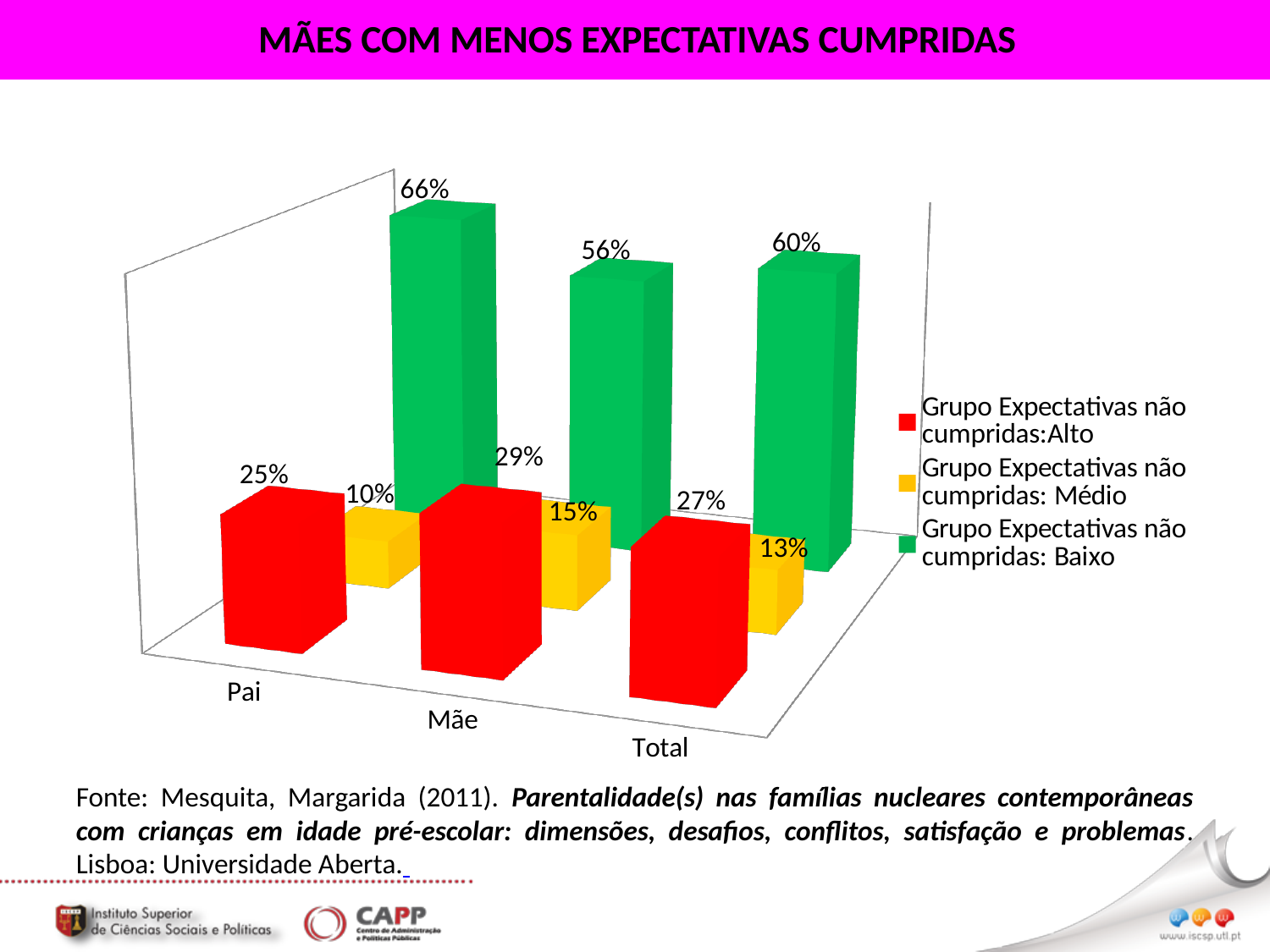
What is the value for Mãe in the series 'Grupo Expectativas não cumpridas: Baixo'? 56% How many series does the legend list? 3 How many categories are shown on the x axis? 3 What is the value for Pai in the series 'Grupo Expectativas não cumpridas: Baixo'? 66% What is the value for Mãe in the series 'Grupo Expectativas não cumpridas:Alto'? 29% What is the value for Total in the series 'Grupo Expectativas não cumpridas: Médio'? 13% Which category has the highest value in the series 'Grupo Expectativas não cumpridas: Baixo'? Pai What kind of chart is shown on the slide? bar chart Which category has the lowest value in the series 'Grupo Expectativas não cumpridas: Médio'? Pai What colour are the bars for the series 'Grupo Expectativas não cumpridas: Médio'? yellow What is the difference between the 'Baixo' values for Pai and Mãe? 10% Which is larger: the 'Alto' value for Mãe or the 'Alto' value for Pai? Mãe